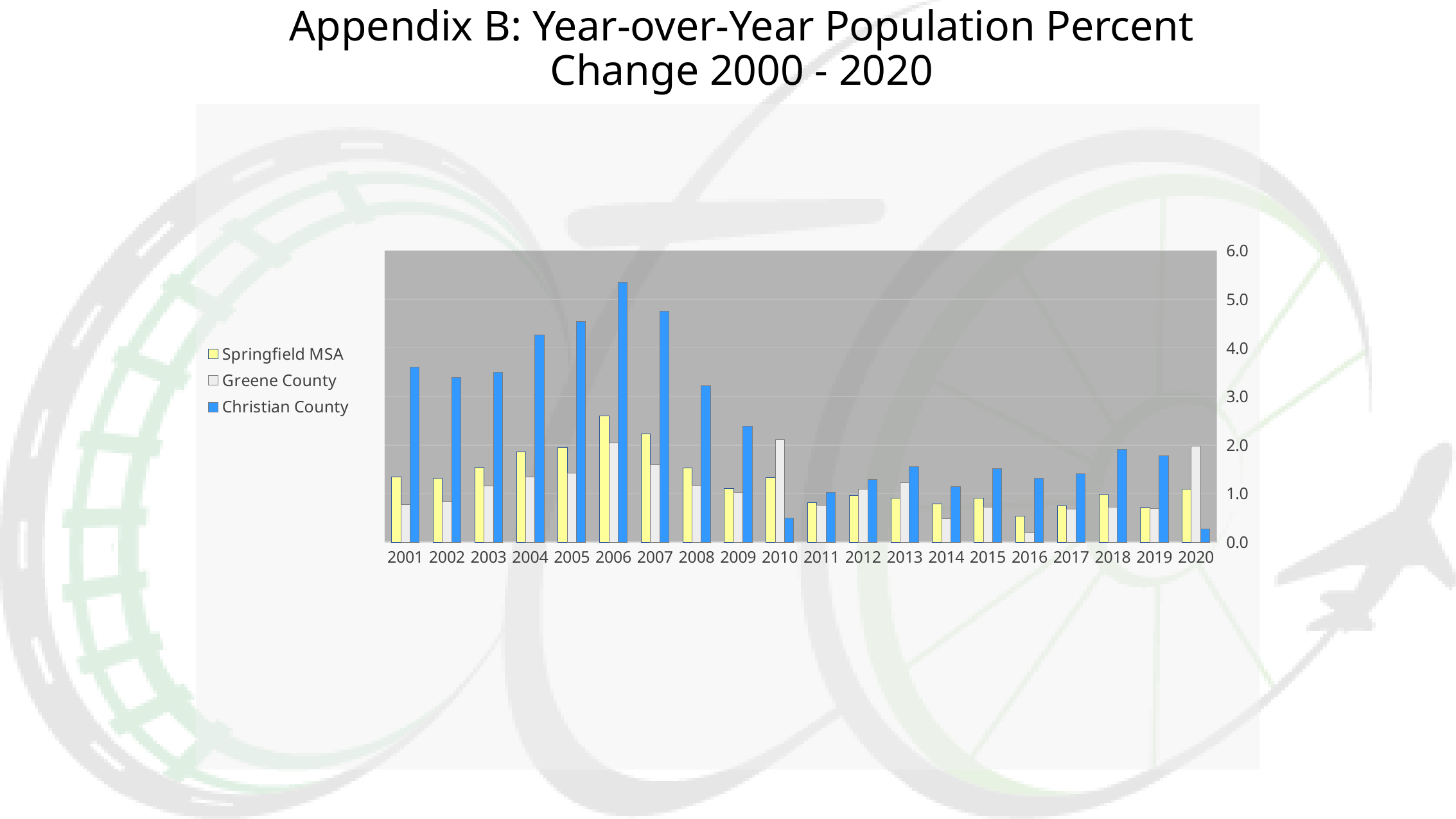
Is the value for Christian County in 2006 greater or less than 5.0? greater Does the Christian County value rise or fall from 2006 to 2010? fall In which year is the Greene County value lowest? 2016 How many series does the legend list? 3 Is the value for Christian County in 2010 greater or less than 1.0? less What kind of chart is shown on the slide? bar chart In which year is the Christian County value highest? 2006 Is the value for Springfield MSA in 2006 greater or less than 2.0? greater In 2010, which is larger: the Greene County value or the Christian County value? Greene County How many years are shown along the x axis? 20 Which series is shown in blue? Christian County In which year is the Springfield MSA value highest? 2006